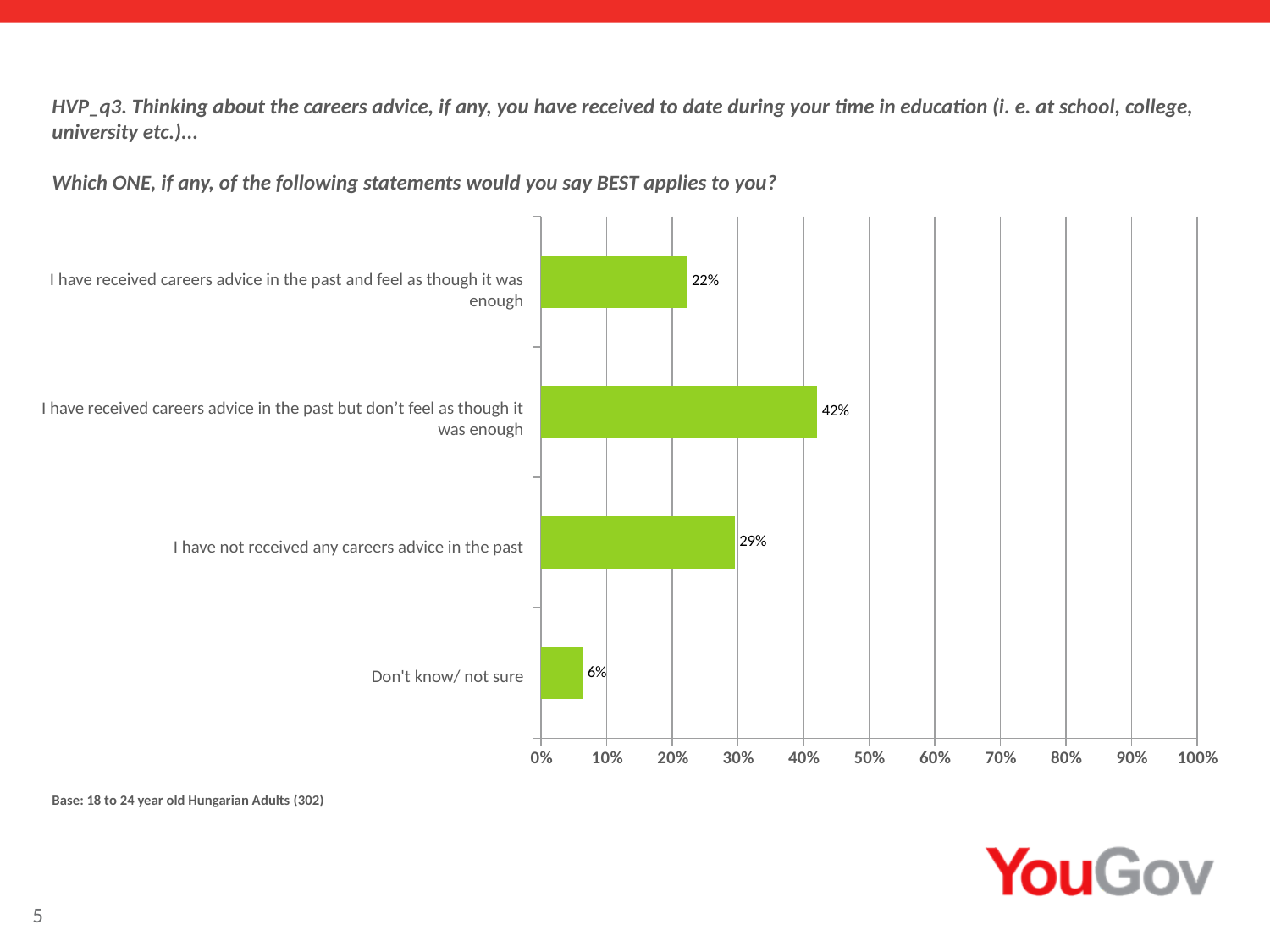
What kind of chart is shown on the slide? Bar chart What percentage of respondents answered 'Don't know/ not sure'? 6% Which statement has the lowest percentage of respondents? Don't know/ not sure What percentage of respondents said they have not received any careers advice in the past? 29% What is the base (sample) described below the chart? 18 to 24 year old Hungarian Adults (302) How many statements (categories) are shown in the chart? 4 Is the value for 'I have received careers advice in the past and feel as though it was enough' greater or less than 30%? less Which statement has the highest percentage of respondents? I have received careers advice in the past but don't feel as though it was enough What colour are the bars in the chart? Green What percentage of respondents said they have received careers advice in the past but don't feel as though it was enough? 42% What is the difference in percentage points between those who received careers advice but don't feel it was enough and those who received it and feel it was enough? 20 Which is larger: the percentage who have not received any careers advice in the past, or the percentage who received careers advice and feel it was enough? I have not received any careers advice in the past